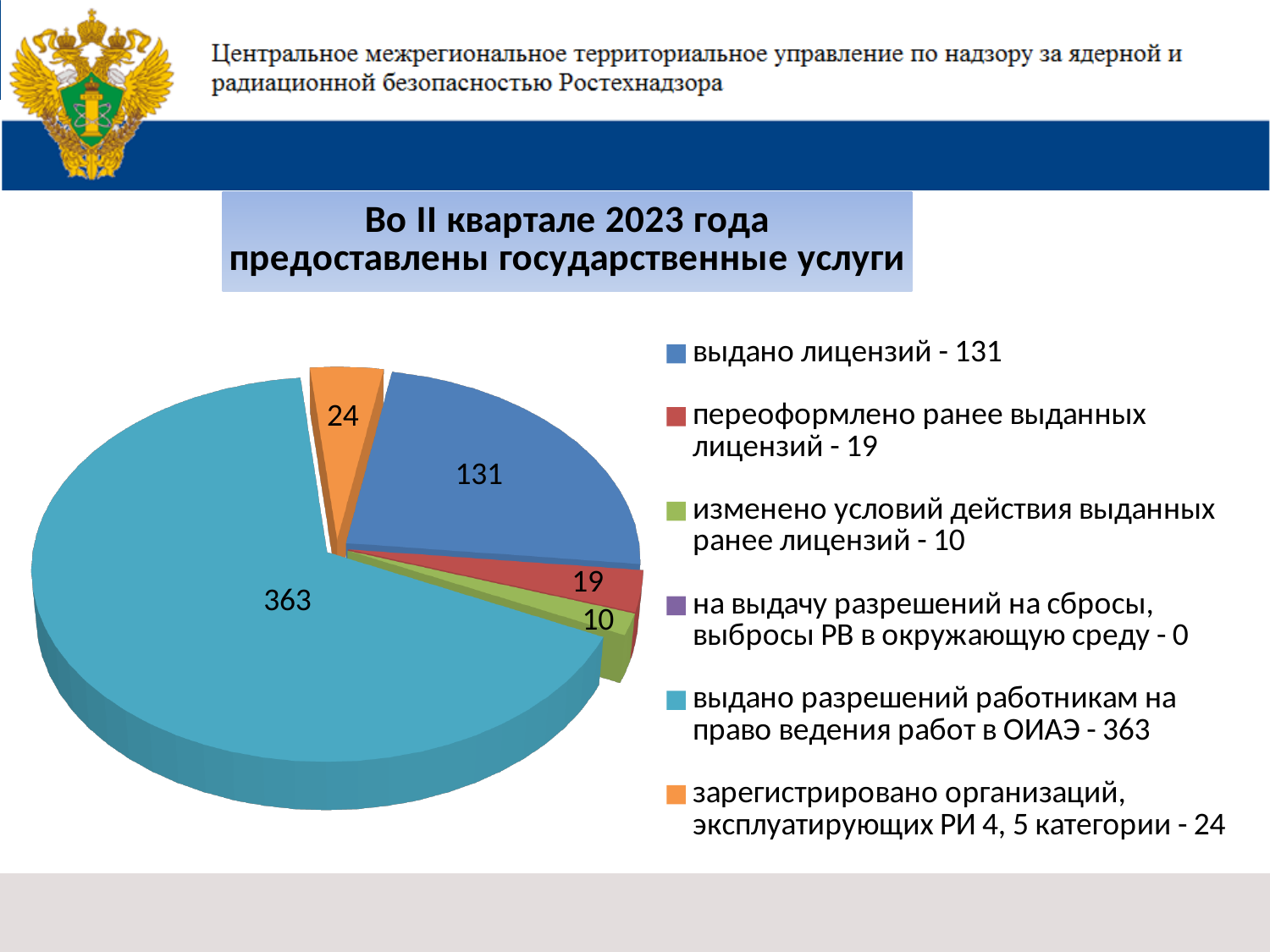
What is the value for "переоформлено ранее выданных лицензий"? 19 What is the value for "на выдачу разрешений на сбросы, выбросы РВ в окружающую среду"? 0 What is the value for "выдано разрешений работникам на право ведения работ в ОИАЭ"? 363 What is the difference between the value for "выдано разрешений работникам на право ведения работ в ОИАЭ" and the value for "выдано лицензий"? 232 Which is larger: the value for "зарегистрировано организаций, эксплуатирующих РИ 4, 5 категории" or the value for "переоформлено ранее выданных лицензий"? зарегистрировано организаций, эксплуатирующих РИ 4, 5 категории What colour is the slice for "выдано лицензий"? blue Which category has the largest slice of the pie? выдано разрешений работникам на право ведения работ в ОИАЭ What type of chart is shown on the slide? pie chart How many entries does the legend list? 6 What is the value for "выдано лицензий"? 131 Which category has the smallest value in the legend? на выдачу разрешений на сбросы, выбросы РВ в окружающую среду What is the value for "зарегистрировано организаций, эксплуатирующих РИ 4, 5 категории"? 24